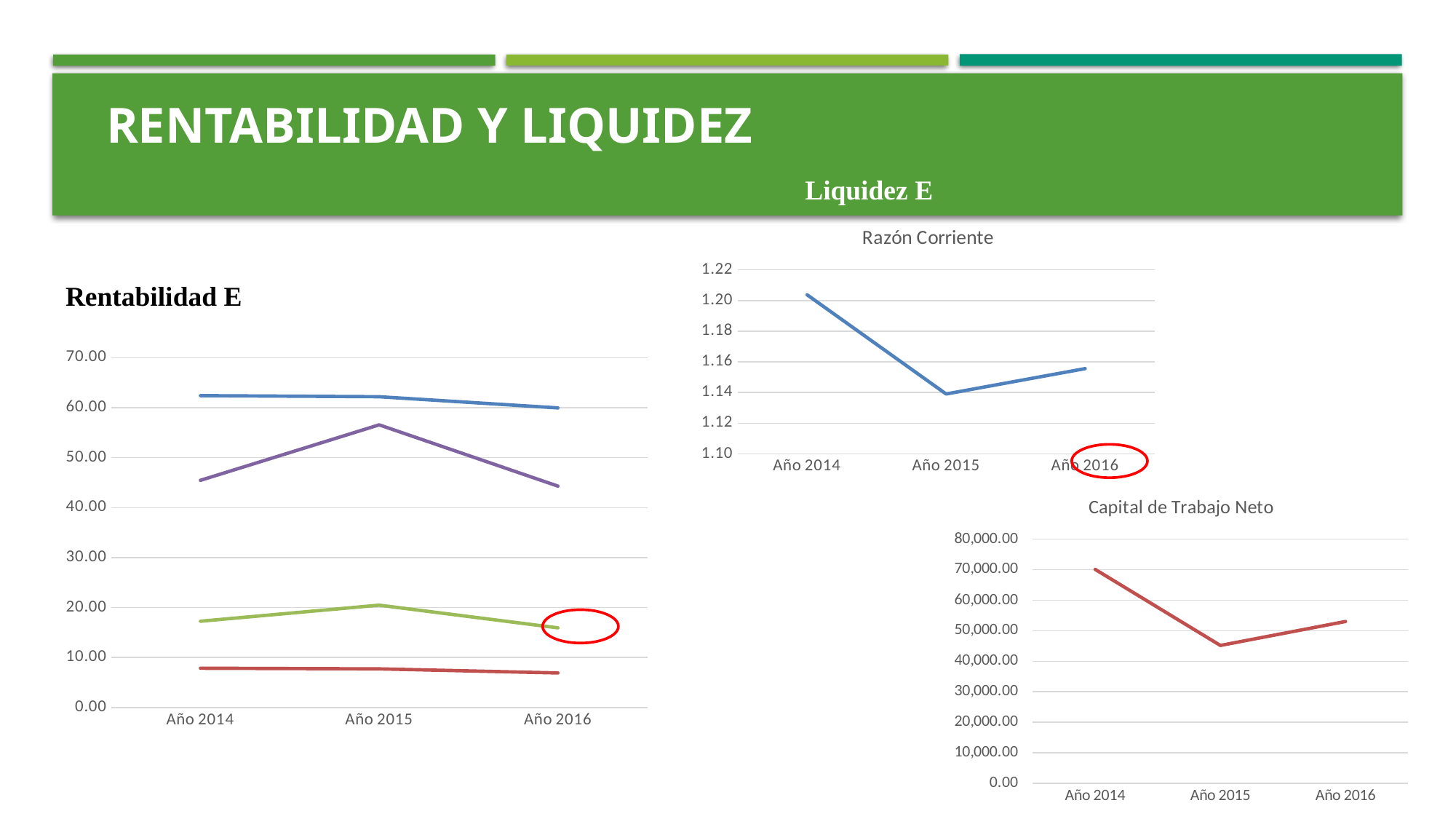
What kind of chart is the 'Razón Corriente' chart? line chart In the 'Capital de Trabajo Neto' chart, is the value for Año 2014 greater or less than 60,000.00? greater In the 'Capital de Trabajo Neto' chart, which is larger, the value for Año 2014 or Año 2016? Año 2014 In the 'Capital de Trabajo Neto' chart, is the value for Año 2015 greater or less than 50,000.00? less In the 'Rentabilidad E' chart on the left, in which year does the purple line reach its highest value? Año 2015 How many years are plotted in the 'Capital de Trabajo Neto' chart? 3 In the 'Razón Corriente' chart, which year has the highest value? Año 2014 How many lines are plotted in the 'Rentabilidad E' chart on the left? 4 In the 'Razón Corriente' chart, is the value for Año 2014 greater or less than 1.18? greater In the 'Razón Corriente' chart, which year has the lowest value? Año 2015 In the 'Capital de Trabajo Neto' chart, which year has the lowest value? Año 2015